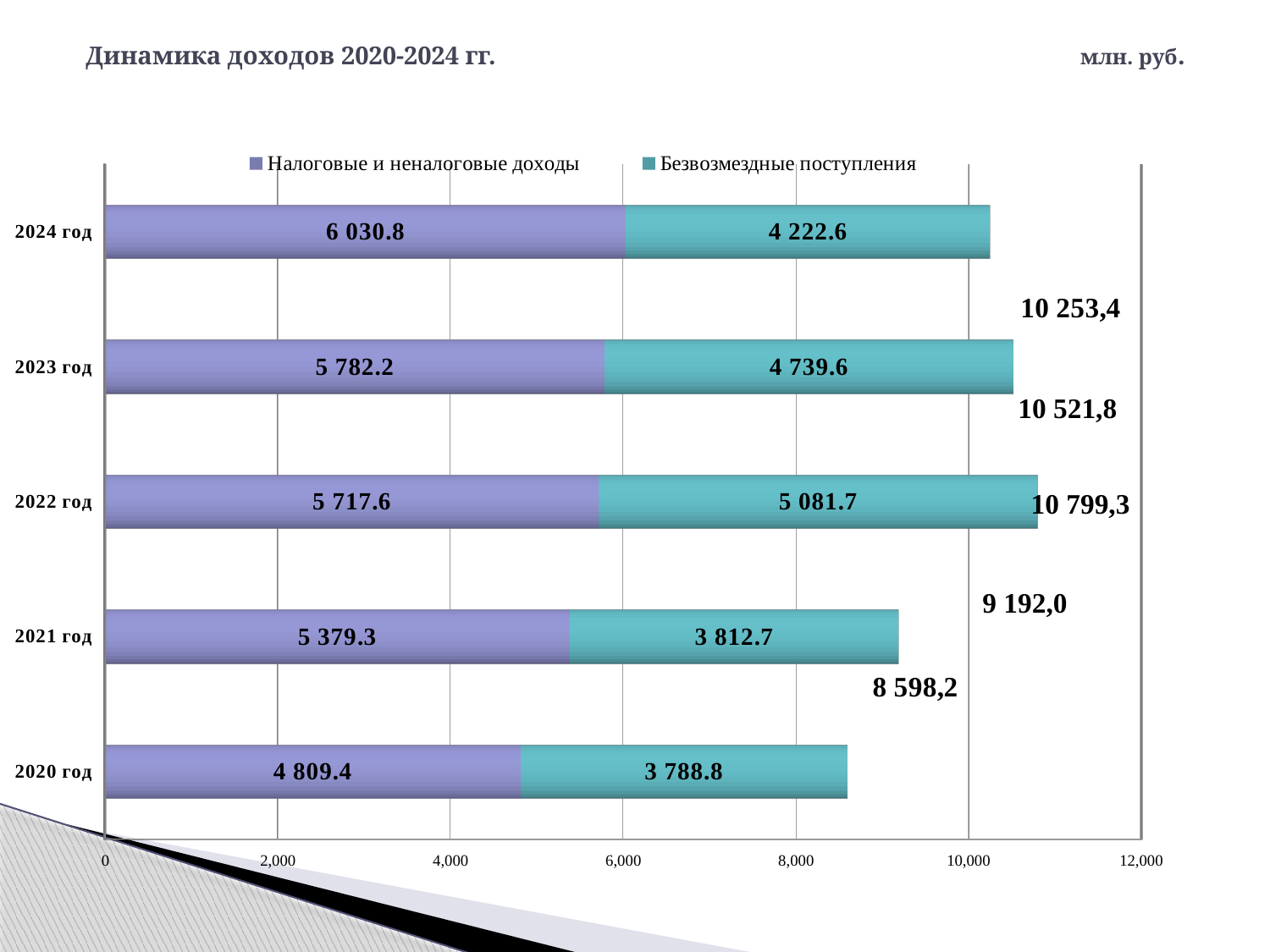
How many series does the legend list? 2 Which year has the highest value for Безвозмездные поступления? 2022 год What is the difference between Налоговые и неналоговые доходы in 2024 год and 2023 год? 248.6 Which is larger: Безвозмездные поступления in 2023 год or in 2024 год? 2023 год What is the value of Безвозмездные поступления for 2021 год? 3 812.7 How many years are shown on the chart? 5 What is the total of the stacked bar for 2020 год? 8 598,2 Which year has the highest value for Налоговые и неналоговые доходы? 2024 год What is the value of Налоговые и неналоговые доходы for 2024 год? 6 030.8 Which year has the lowest value for Безвозмездные поступления? 2020 год What kind of chart is shown on the slide? Stacked bar chart What is the title of the chart? Динамика доходов 2020-2024 гг.